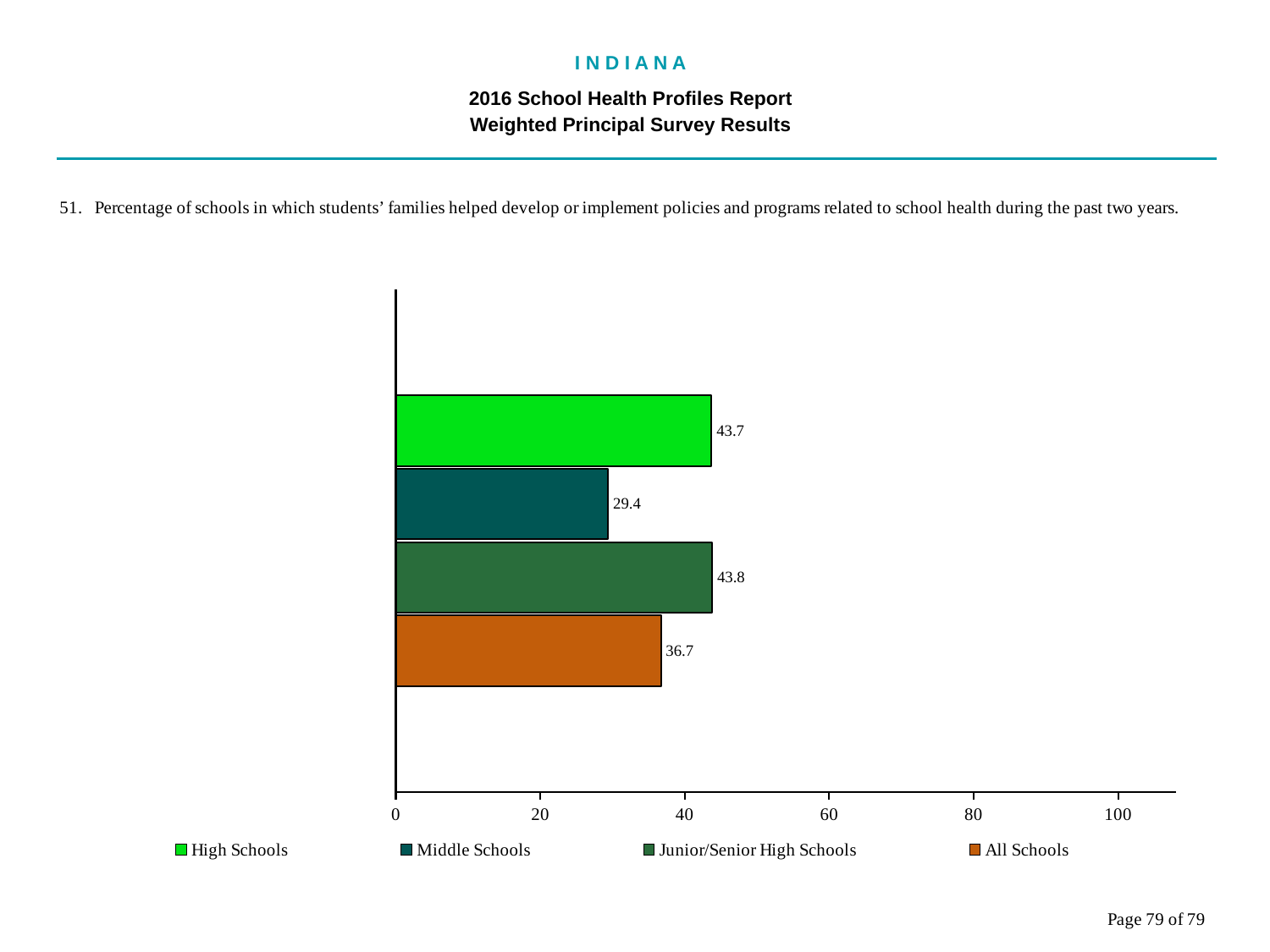
What is the value for High Schools? 43.7 Which school type has the lowest value? Middle Schools What is the value for All Schools? 36.7 How many series does the legend list? 4 Is the value for Middle Schools greater or less than 40? less Which is larger, the value for All Schools or the value for Middle Schools? All Schools What is the difference between the values for Junior/Senior High Schools and All Schools? 7.1 What kind of chart is shown on the slide? bar chart What is the value for Junior/Senior High Schools? 43.8 What is the difference between the values for High Schools and Middle Schools? 14.3 What colour is the bar for All Schools? orange What is the value for Middle Schools? 29.4